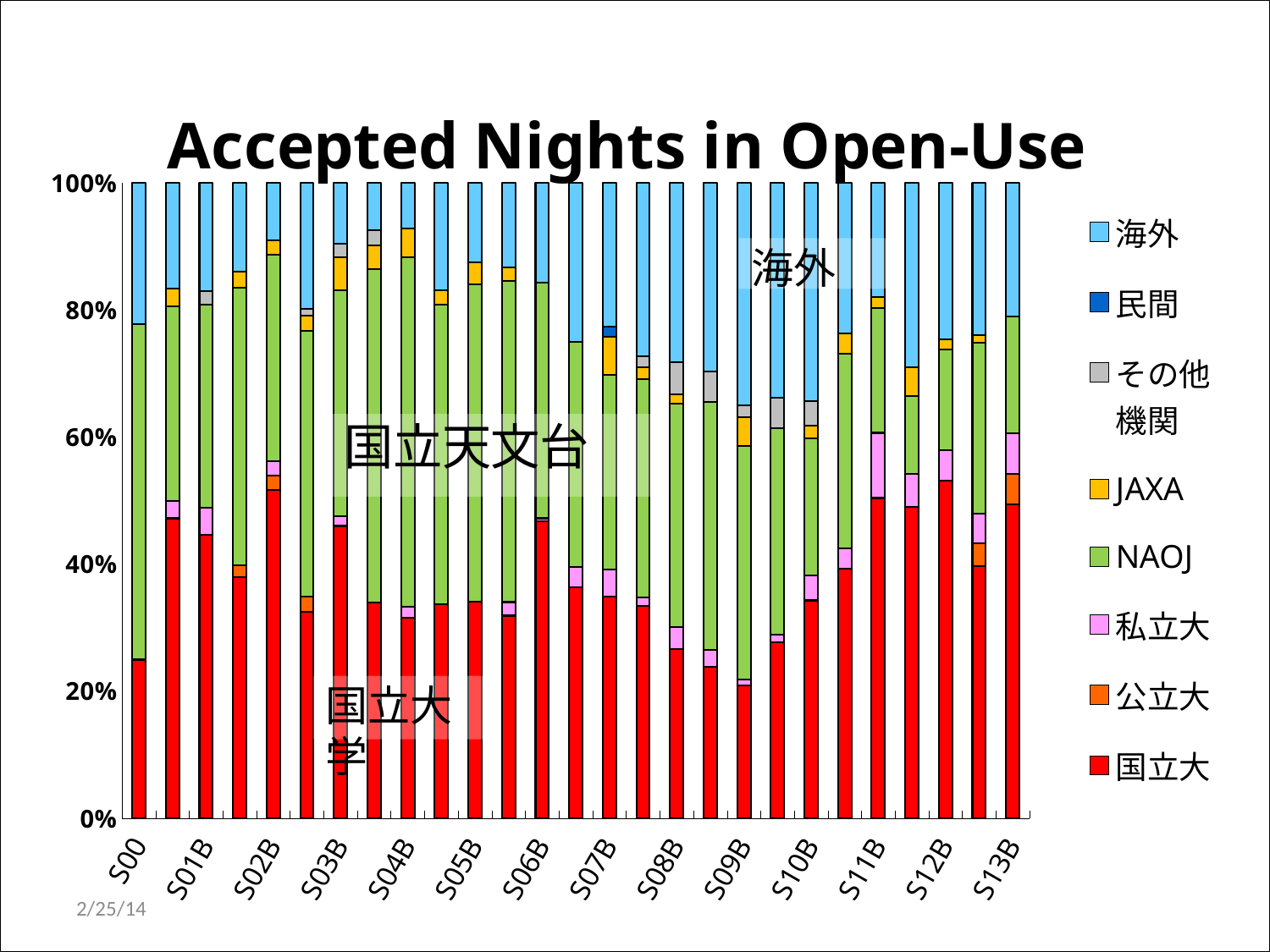
Is the 国立大 share for S09B greater or less than 40%? less What kind of chart is shown on the slide? stacked bar chart What is the title of the chart? Accepted Nights in Open-Use Is the 国立大 share for S00 greater or less than 40%? less Which has the larger 国立大 share, S02B or S00? S02B How many series does the legend list? 8 How many category labels are shown along the x axis? 14 Which colour represents 国立大 in the chart? red Is the 国立大 share for S02B greater or less than 40%? greater Which has the larger 海外 share, S10B or S02B? S10B